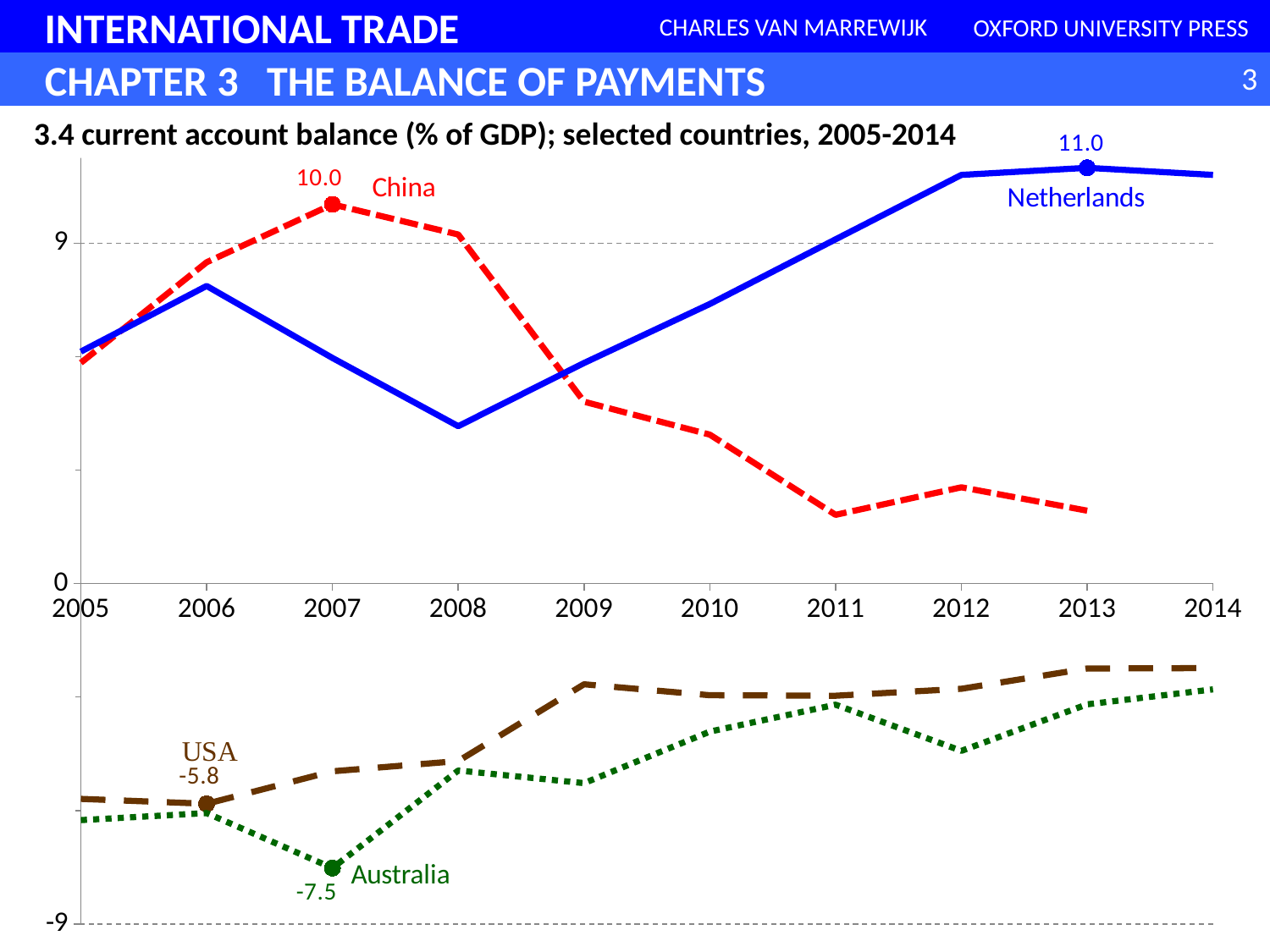
What is the current account balance for China in 2007? 10.0 How much higher is the Netherlands' 2013 value than China's 2007 value? 1.0 What is the current account balance for the USA in 2006? -5.8 Which country reaches the lowest point on the chart? Australia What is the difference between the USA's 2006 value and Australia's 2007 value? 1.7 Is the Netherlands' value in 2012 greater or less than 9? greater Which is larger: China's value in 2007 or the Netherlands' value in 2013? Netherlands' value in 2013 Does China's current account balance rise or fall from 2007 to 2011? fall What is the current account balance for Australia in 2007? -7.5 What is the current account balance for the Netherlands in 2013? 11.0 How many countries are plotted on the chart? 4 What kind of chart is shown on the slide? line chart